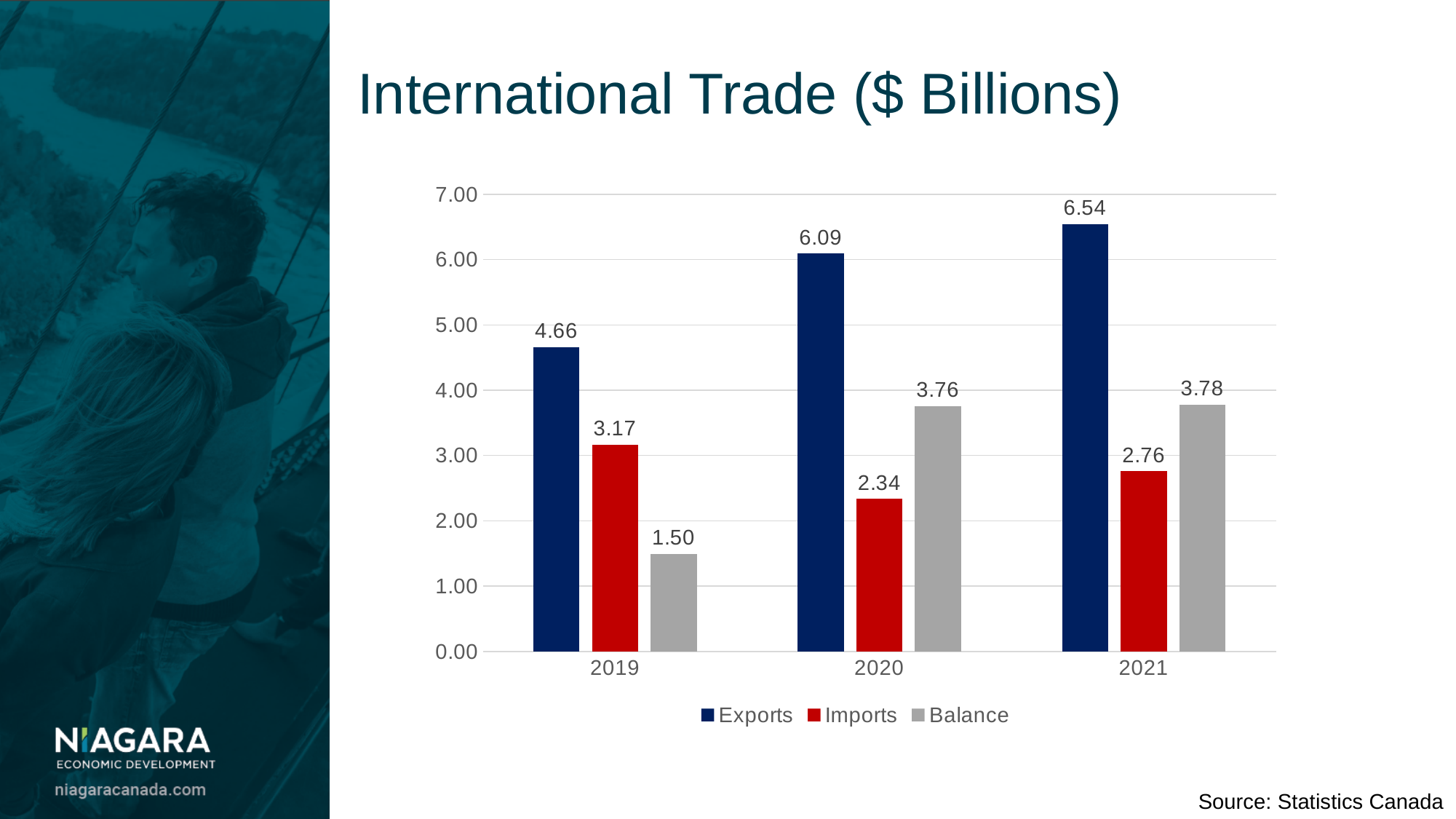
How many years are shown on the x axis? 3 Which is larger in 2019, Imports or Balance? Imports Is the value for Exports in 2019 greater or less than 4.00? greater What is the value of Balance in 2021? 3.78 What is the value of Imports in 2019? 3.17 What kind of chart is shown on the slide? Bar chart What is the difference between Exports and Imports in 2021? 3.78 Do Exports rise or fall from 2019 to 2021? Rise In which year are Imports lowest? 2020 In which year are Exports highest? 2021 What is the value of Exports in 2020? 6.09 How many series does the legend list? 3